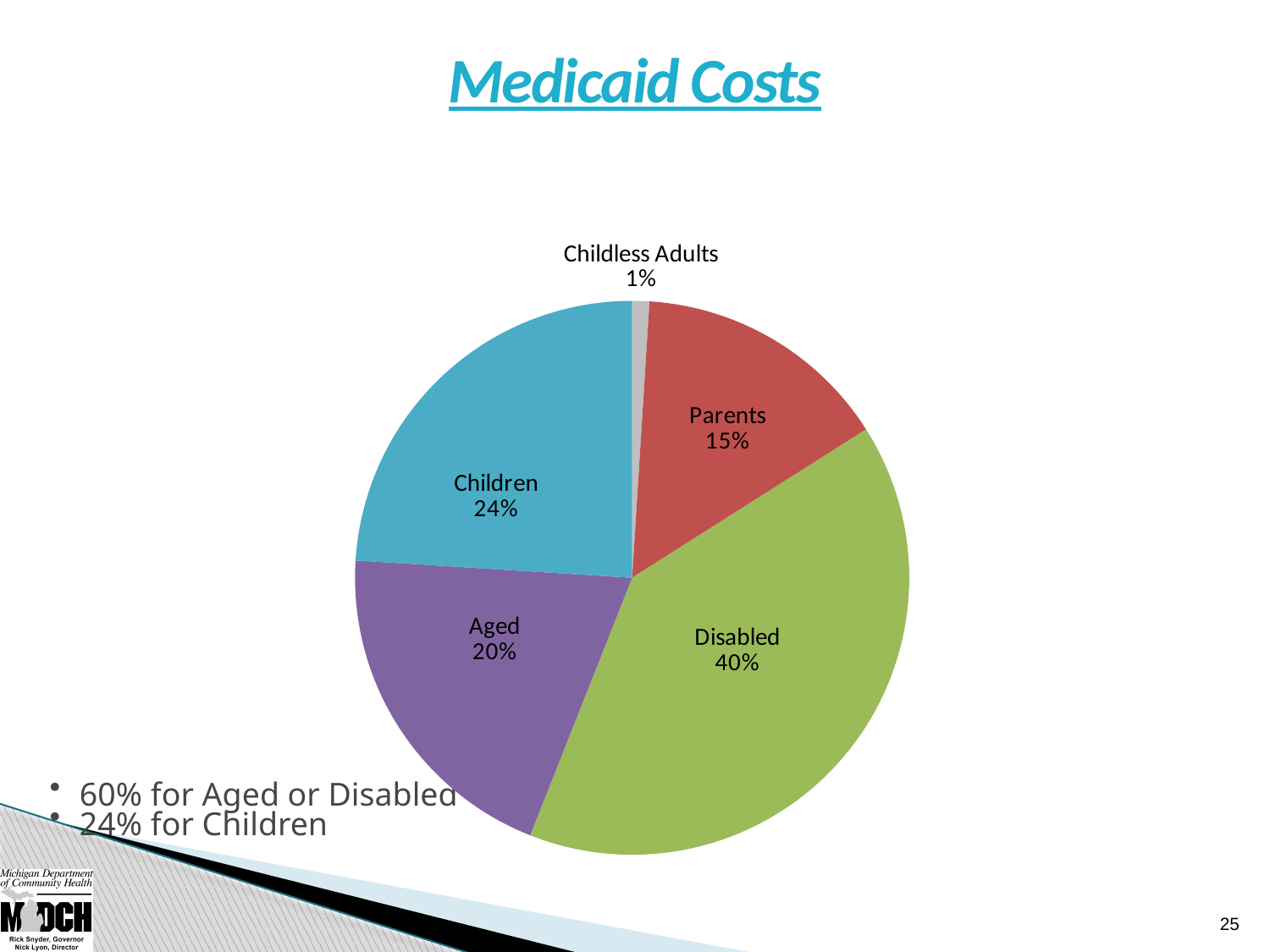
What is the difference in percentage points between the Disabled and Aged shares? 20 What is the title of the chart? Medicaid Costs What type of chart is shown on the slide? pie chart What is the combined share of Aged and Disabled? 60% What share of Medicaid costs is for Childless Adults? 1% What share of Medicaid costs is for Children? 24% Which has a larger share of Medicaid costs, Children or Aged? Children Which category has the smallest share of Medicaid costs? Childless Adults Which category has the largest share of Medicaid costs? Disabled How many categories are shown in the pie chart? 5 What share of Medicaid costs is for Parents? 15% What share of Medicaid costs is for Disabled? 40%